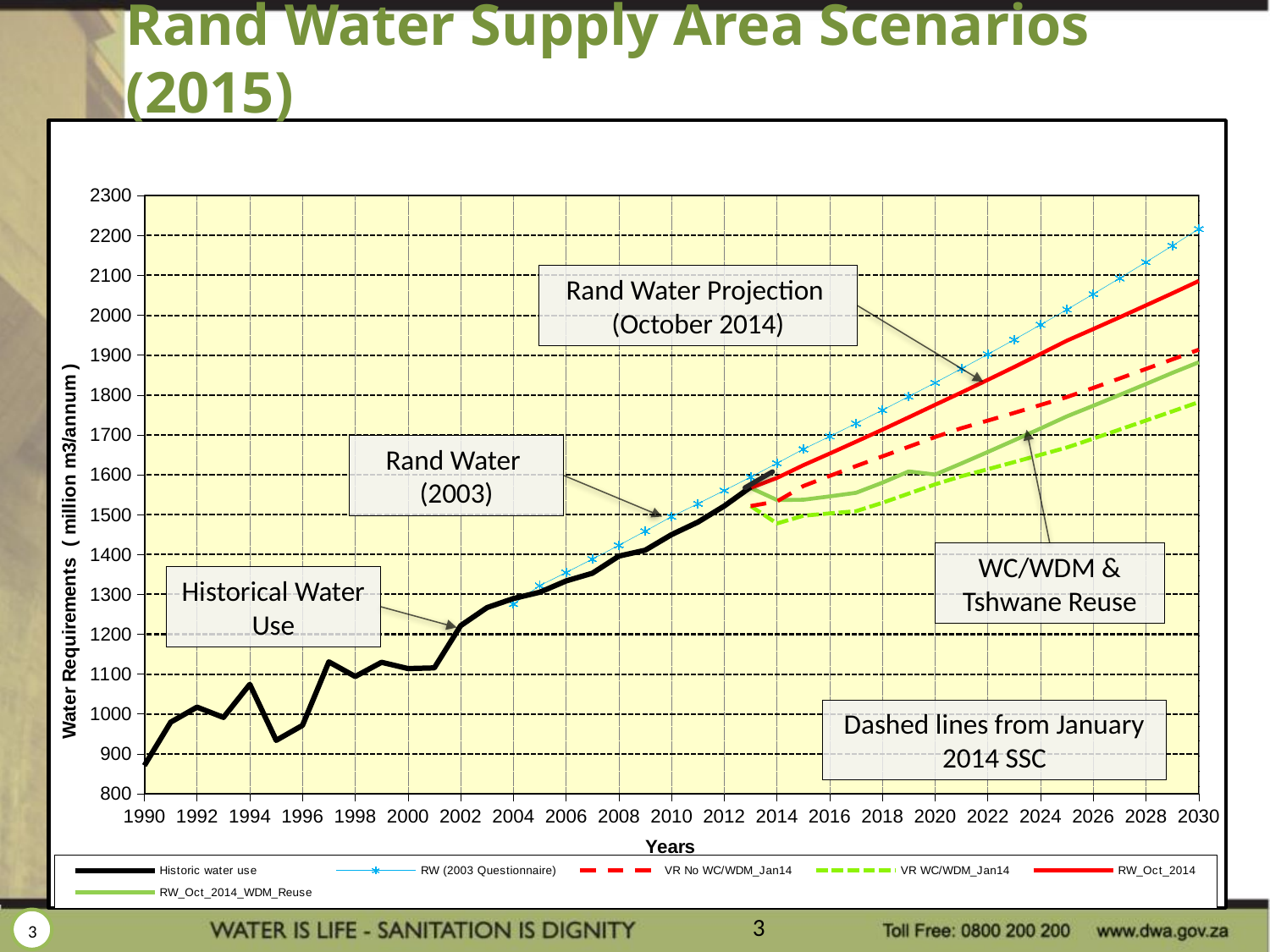
How many series does the chart legend list? 6 Is the value for RW (2003 Questionnaire) in 2030 greater or less than 2100? greater In 2030, which series has the higher value: VR No WC/WDM_Jan14 or VR WC/WDM_Jan14? VR No WC/WDM_Jan14 In 2030, which series has the higher value: RW (2003 Questionnaire) or RW_Oct_2014? RW (2003 Questionnaire) Is the value for VR WC/WDM_Jan14 in 2030 greater or less than 1700? greater Which series has the highest value in 2030? RW (2003 Questionnaire) What is the label of the horizontal axis? Years Is the value for Historic water use in 2012 greater or less than 1500? greater What is the label of the vertical axis? Water Requirements ( million m3/annum) What kind of chart is shown on the slide? line chart